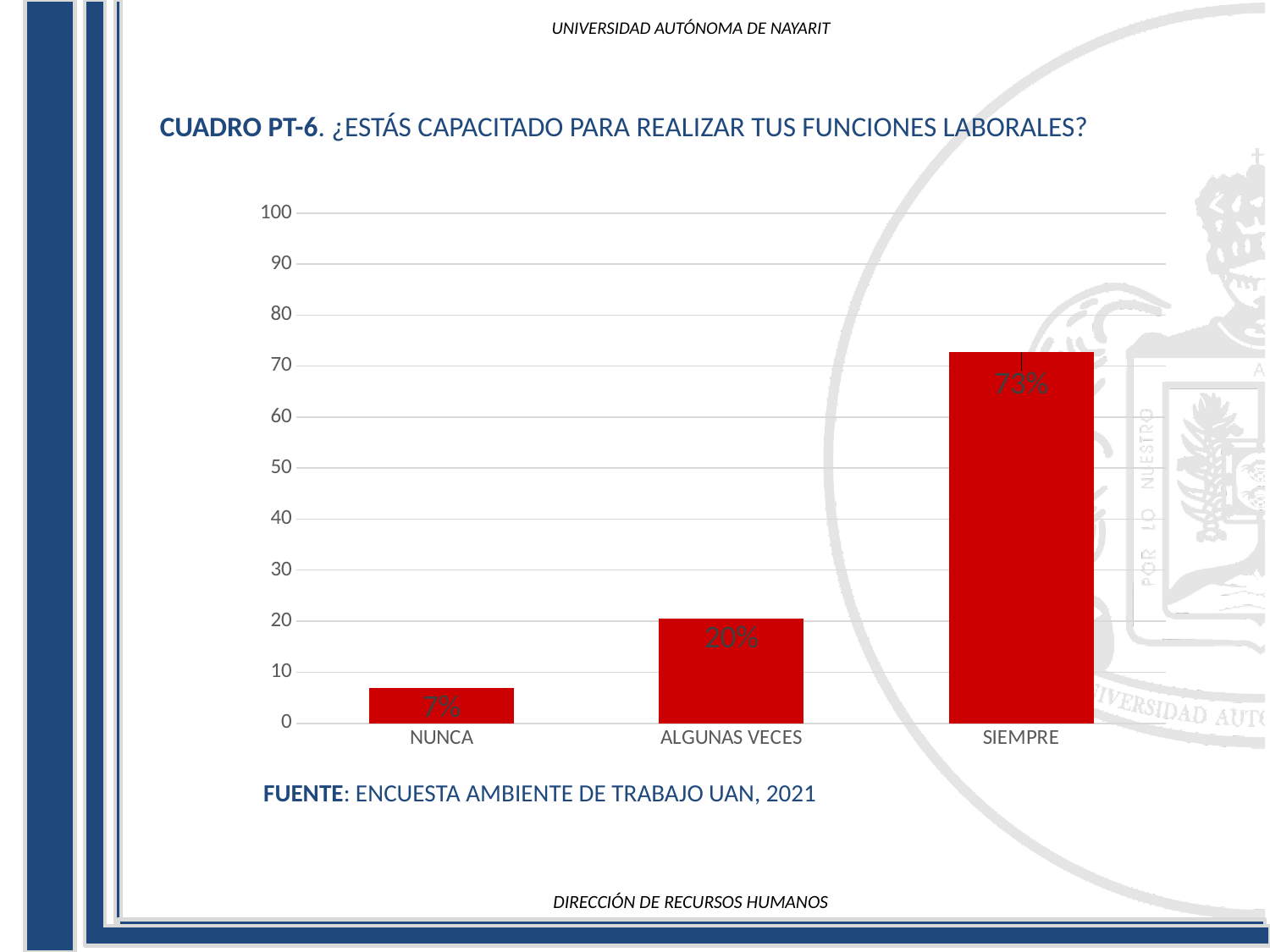
What is the difference between the values for ALGUNAS VECES and NUNCA? 13% How many categories are shown on the x axis? 3 Which is larger, the value for ALGUNAS VECES or the value for NUNCA? ALGUNAS VECES What is the value for NUNCA? 7% Is the value for SIEMPRE greater or less than 60? greater What is the value for ALGUNAS VECES? 20% What is the difference between the values for SIEMPRE and ALGUNAS VECES? 53% What kind of chart is shown on the slide? bar chart What is the value for SIEMPRE? 73% What source is cited below the chart? ENCUESTA AMBIENTE DE TRABAJO UAN, 2021 Which category has the highest value? SIEMPRE Which category has the lowest value? NUNCA